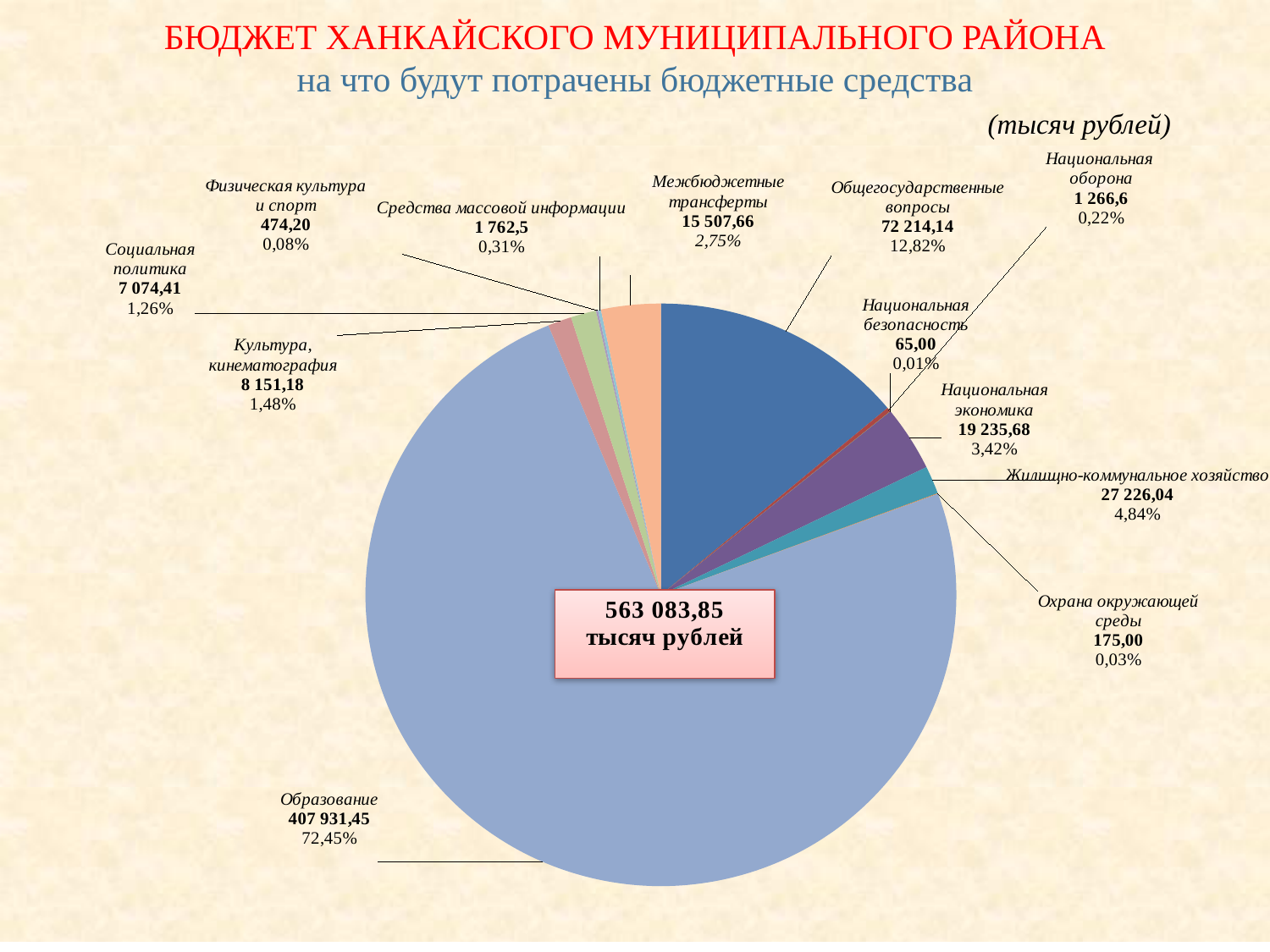
What is the value for Жилищно-коммунальное хозяйство? 27 226,04 What share of the pie does Национальная экономика take? 3,42% What total amount is shown in the box at the centre of the pie chart? 563 083,85 тысяч рублей Which category has the smallest slice in the pie chart? Национальная безопасность How many categories (slices) does the pie chart show? 12 What kind of chart is shown on the slide? pie chart What is the value for Охрана окружающей среды? 175,00 What share of the pie does Общегосударственные вопросы take? 12,82% Which category has the largest slice in the pie chart? Образование What is the difference between the values for Культура, кинематография and Социальная политика? 1 076,77 Which is larger: Межбюджетные трансферты or Социальная политика? Межбюджетные трансферты What is the value for Образование in the pie chart? 407 931,45